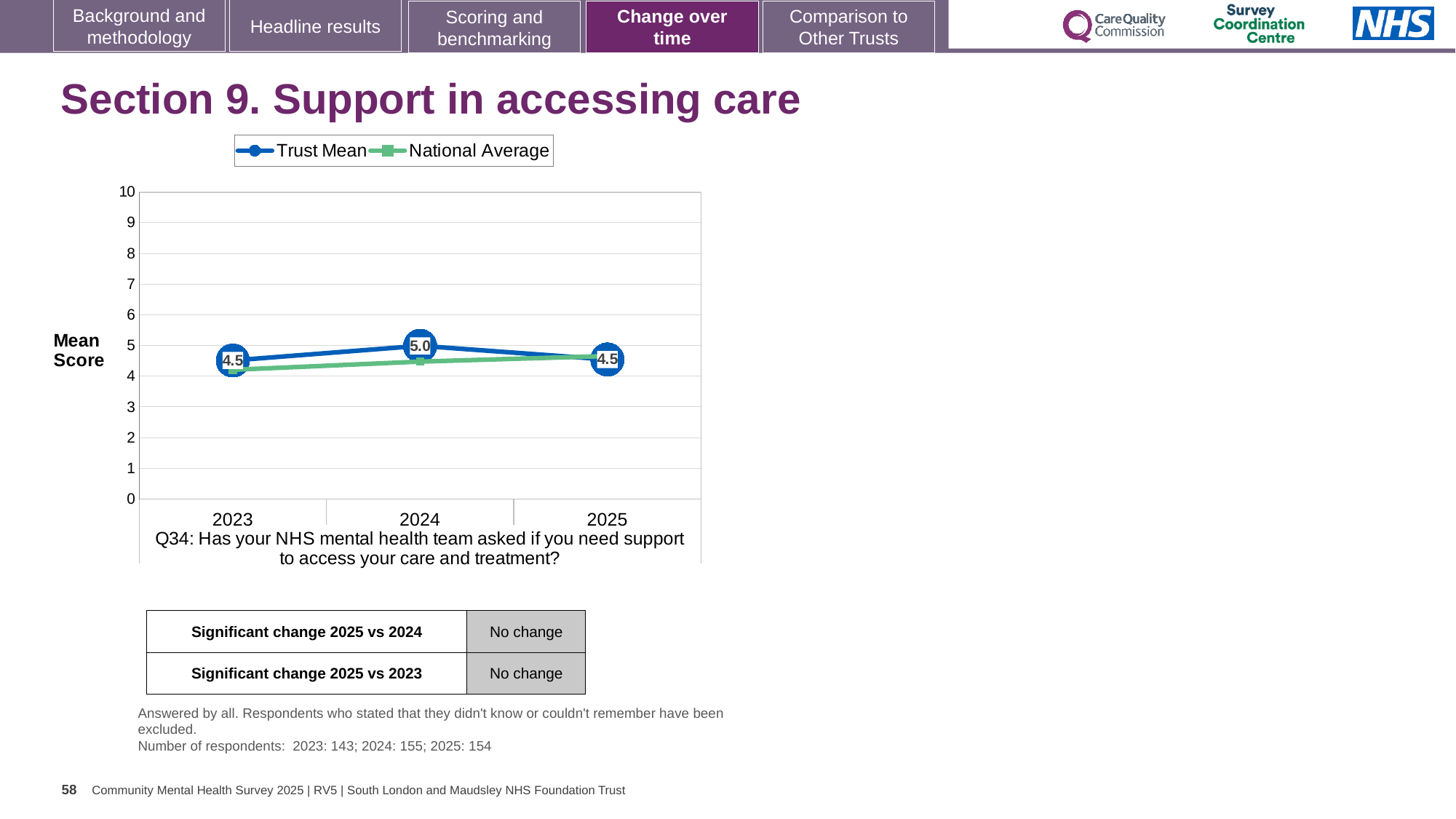
How many years are shown on the x axis of the chart? 3 How many series does the chart legend list? 2 In 2023, which is higher, the Trust Mean or the National Average? Trust Mean In which year is the Trust Mean highest? 2024 What are the two series named in the chart legend? Trust Mean and National Average Which is larger, the Trust Mean in 2024 or the Trust Mean in 2025? 2024 What is the Trust Mean score for 2023? 4.5 What is the difference between the Trust Mean in 2024 and in 2023? 0.5 What is the Trust Mean score for 2024? 5.0 What kind of chart is shown on the slide? line chart What is the Trust Mean score for 2025? 4.5 Is the National Average value for 2023 greater or less than 5? less